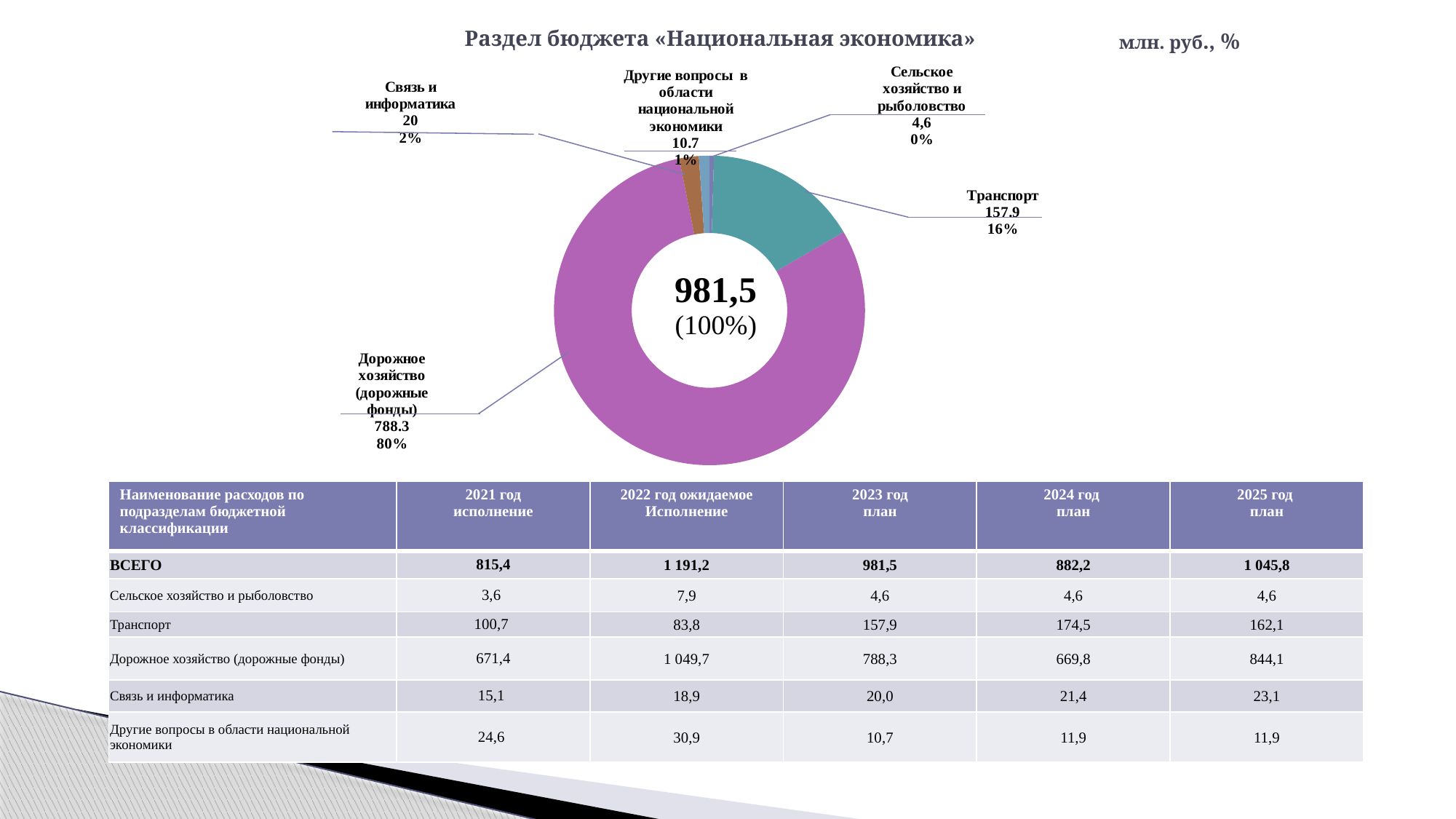
What total value is shown in the centre of the donut chart? 981,5 What value is shown for Дорожное хозяйство (дорожные фонды) in the donut chart? 788.3 Which category has the smallest slice in the donut chart? Сельское хозяйство и рыболовство Which is larger in the donut chart: Транспорт or Связь и информатика? Транспорт Which category has the largest slice in the donut chart? Дорожное хозяйство (дорожные фонды) What value is shown for Сельское хозяйство и рыболовство in the donut chart? 4,6 What share of the donut chart does Дорожное хозяйство (дорожные фонды) account for? 80% What value is shown for Связь и информатика in the donut chart? 20 What share of the donut chart does Транспорт account for? 16% How many categories are shown in the donut chart? 5 What value is shown for Транспорт in the donut chart? 157.9 What type of chart is shown on the slide? Donut (pie) chart